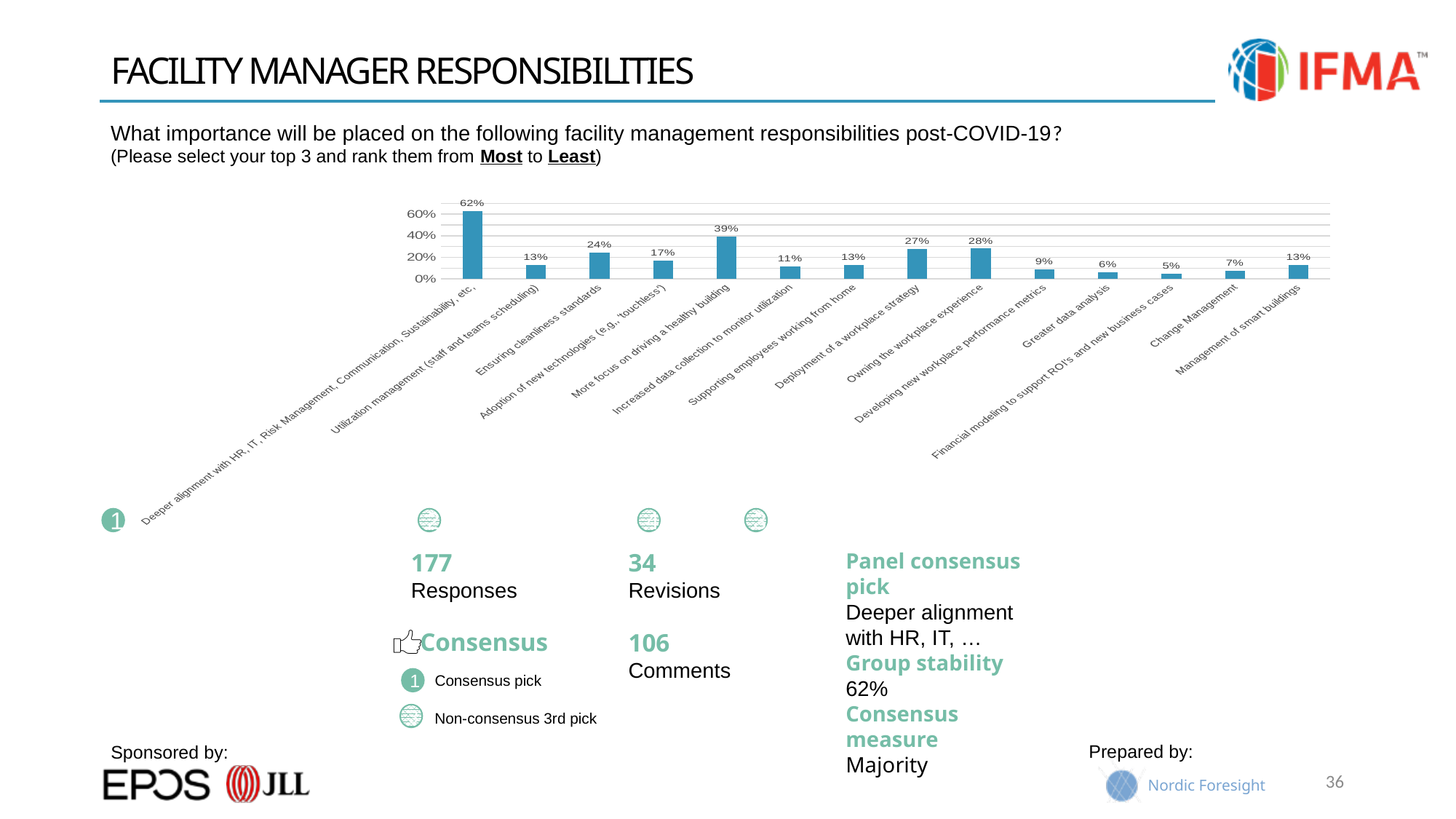
How many categories are plotted in the chart? 14 Is the value for 'Greater data analysis' greater or less than 20%? less What is the difference between the values for 'Deeper alignment with HR, IT, Risk Management, Communication, Sustainability, etc.' and 'More focus on driving a healthy building'? 23% What is the value for 'Increased data collection to monitor utilization'? 11% What is the value for 'Ensuring cleanliness standards'? 24% Which category has the highest value in the chart? Deeper alignment with HR, IT, Risk Management, Communication, Sustainability, etc. What is the value for 'Change Management'? 7% Which category has the lowest value in the chart? Financial modeling to support ROI's and new business cases What is the value for 'More focus on driving a healthy building'? 39% What is the value for 'Owning the workplace experience'? 28% Which is larger: the value for 'Deployment of a workplace strategy' or 'Adoption of new technologies (e.g., 'touchless')'? Deployment of a workplace strategy What kind of chart is shown on the slide? bar chart